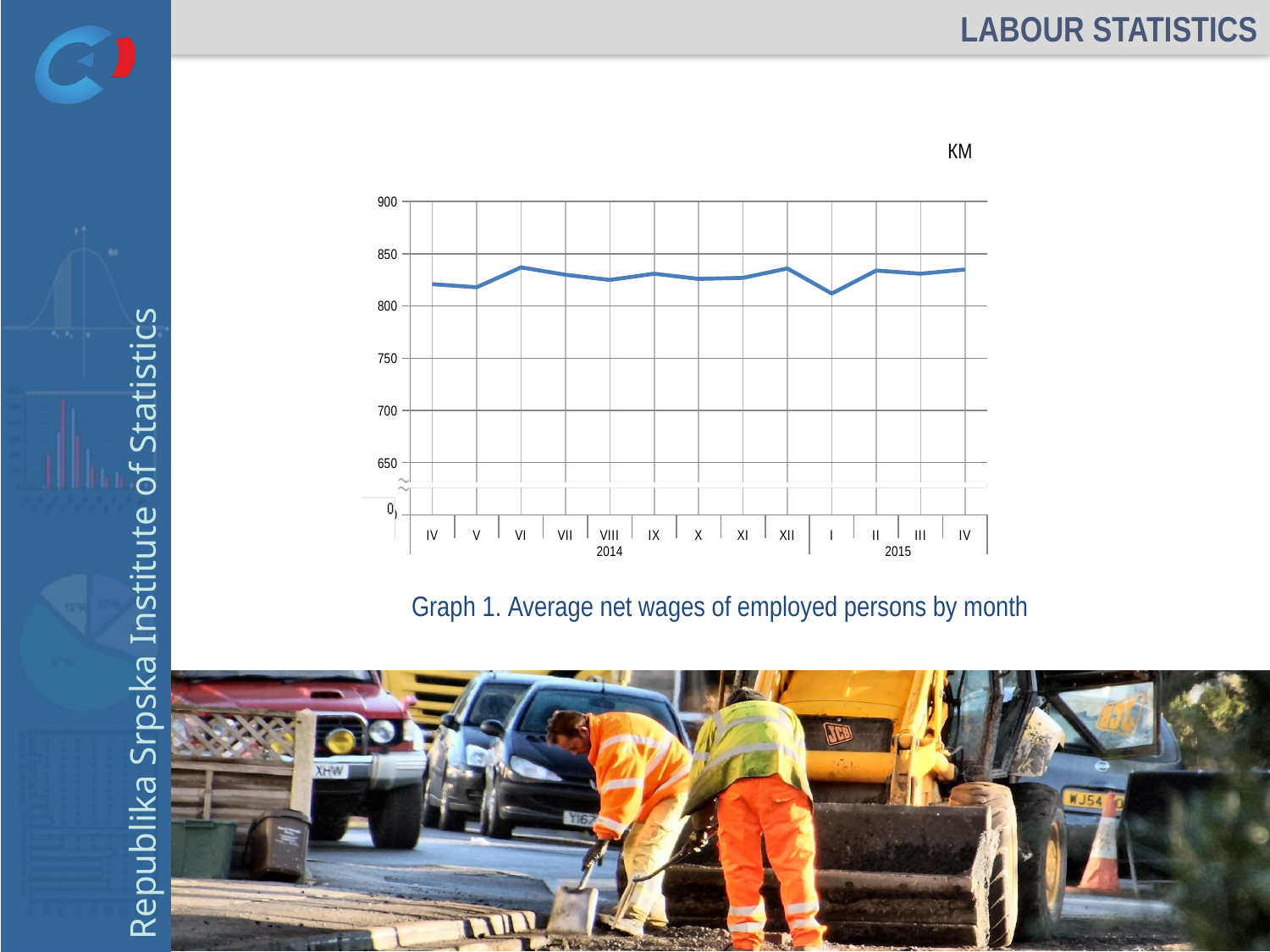
Is the value for I 2015 greater or less than 850? less Does the value rise or fall from I 2015 to II 2015? rise What unit is shown above the chart's y axis? KM Is the value for VI 2014 greater or less than 850? less How many monthly data points are plotted in Graph 1? 13 Which is higher, the value for IV 2014 or the value for VI 2014? VI 2014 Is the value for IV 2014 greater or less than 800? greater What kind of chart is Graph 1? line chart Does the value rise or fall from XII 2014 to I 2015? fall What is the title of the chart on the slide? Graph 1. Average net wages of employed persons by month Which is higher, the value for VI 2014 or the value for I 2015? VI 2014 Which month has the lowest average net wage in Graph 1? I 2015